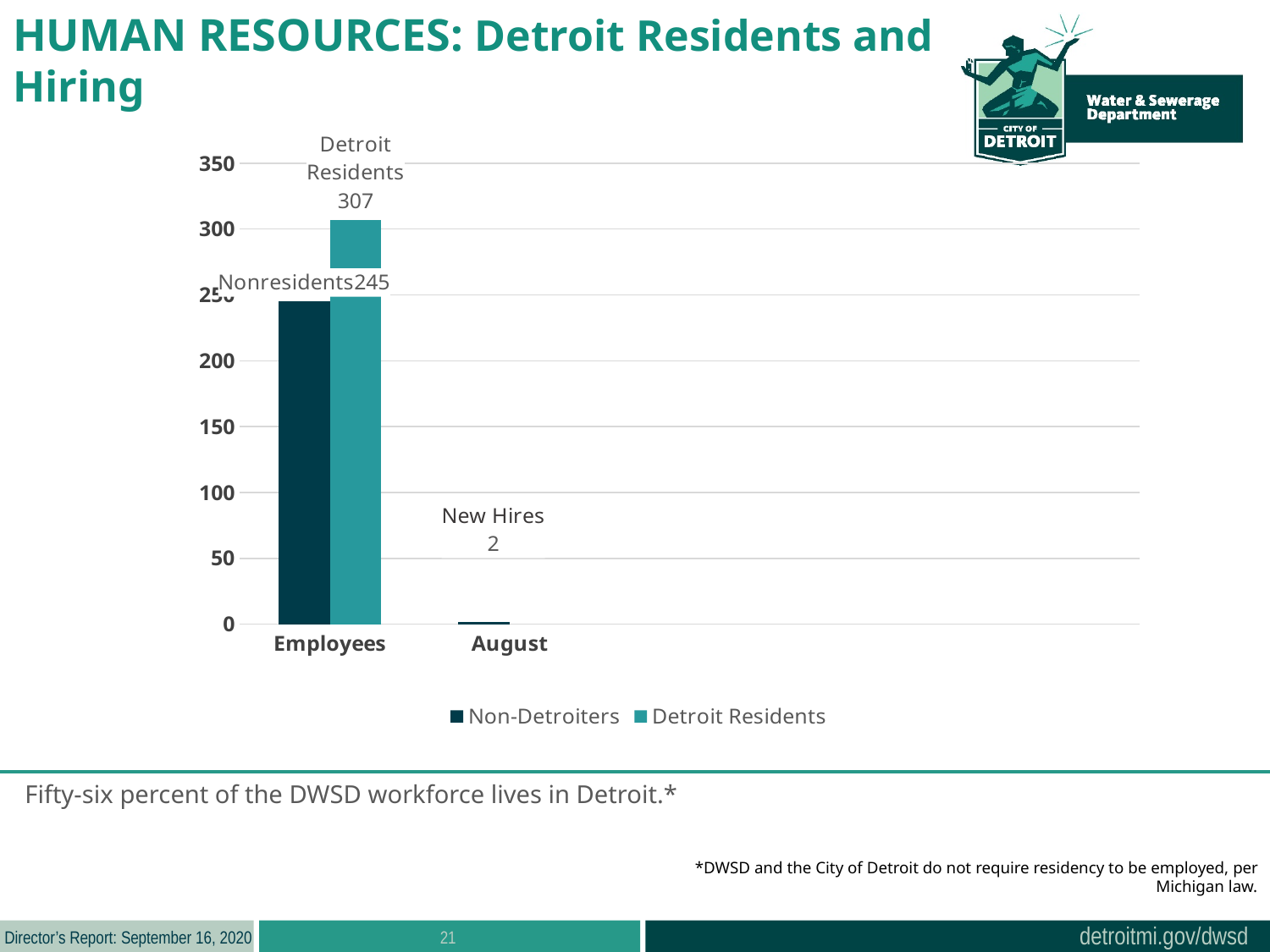
In the Employees category, which is larger: Detroit Residents or Nonresidents? Detroit Residents What is the difference between Detroit Residents (307) and Nonresidents (245) in the Employees category? 62 Which category has the lowest values on the chart? August Is the value for Nonresidents in the Employees category greater or less than 200? greater What type of chart is shown on the slide? bar chart What are the two series named in the legend? Non-Detroiters and Detroit Residents What is the value labelled for New Hires in the August category? 2 How many categories are shown on the x axis? 2 How many series does the legend list? 2 What is the value labelled for Nonresidents in the Employees category? 245 What is the value labelled for Detroit Residents in the Employees category? 307 What is the total of Detroit Residents and Nonresidents in the Employees category? 552